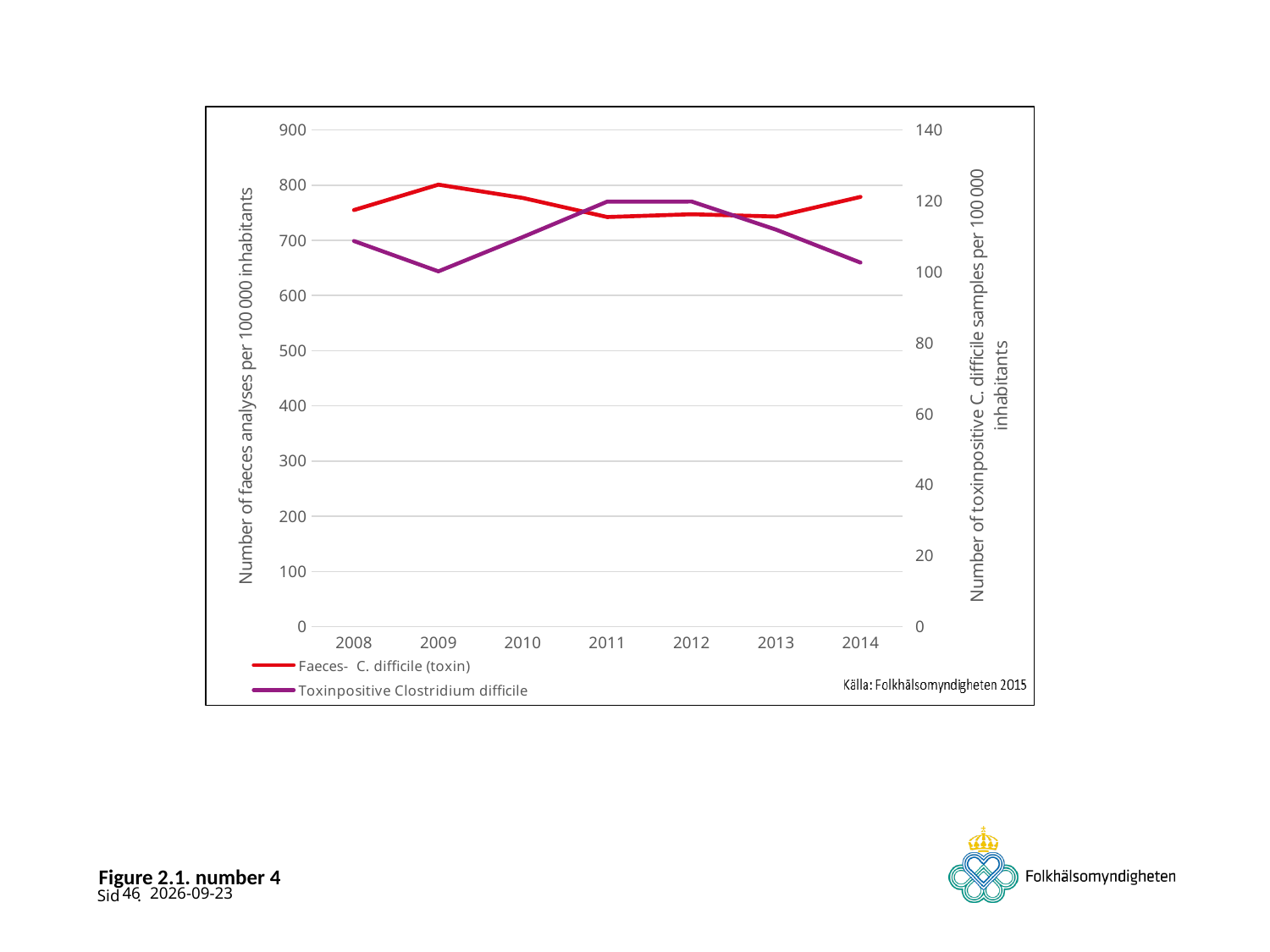
What kind of chart is shown on the slide? line chart Is the value for Faeces- C. difficile (toxin) in 2014 greater or less than 700? greater Is the value for Faeces- C. difficile (toxin) in 2008 greater or less than 800? less What is the title of the left vertical axis? Number of faeces analyses per 100 000 inhabitants How many series does the legend list? 2 Is the value for Toxinpositive Clostridium difficile in 2009 greater or less than 120 on the right axis? less What colour is the line for Toxinpositive Clostridium difficile? purple How many years are shown on the x axis? 7 Does the Faeces- C. difficile (toxin) series rise or fall from 2009 to 2011? fall Does the Toxinpositive Clostridium difficile series rise or fall from 2009 to 2011? rise In which year is the Faeces- C. difficile (toxin) series at its highest? 2009